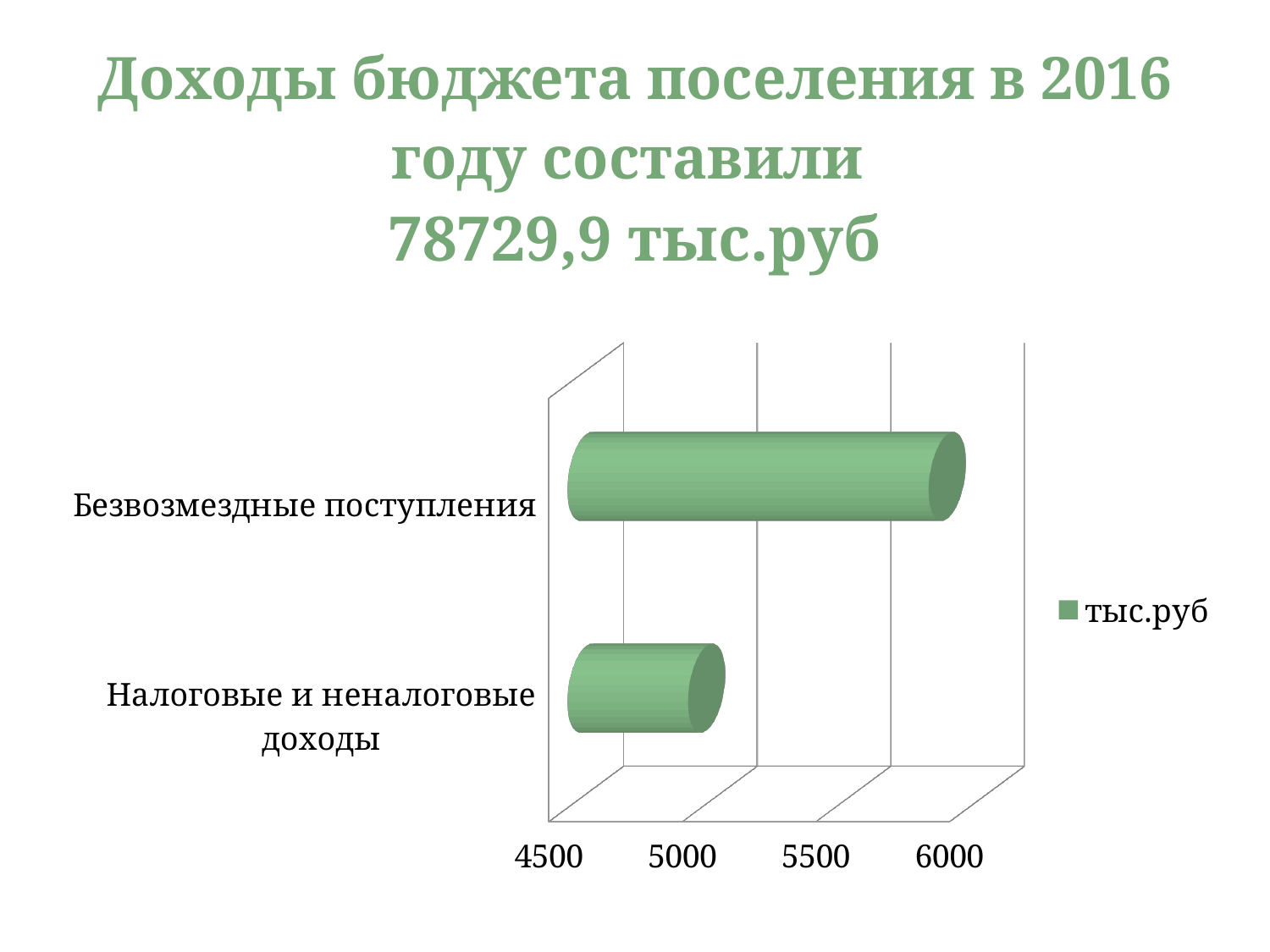
How many series does the legend list? 1 What kind of chart is shown on the slide? bar chart Which category has the lowest value in the chart? Налоговые и неналоговые доходы How many categories are plotted in the chart? 2 Which category has the highest value in the chart? Безвозмездные поступления Is the value for Безвозмездные поступления greater or less than 5500? greater Which is larger: the value for Безвозмездные поступления or the value for Налоговые и неналоговые доходы? Безвозмездные поступления Is the value for Налоговые и неналоговые доходы greater or less than 4500? greater What is the legend entry shown in the chart? тыс.руб According to the slide title, what were the total budget revenues of the settlement in 2016? 78729,9 тыс.руб Is the value for Налоговые и неналоговые доходы greater or less than 5500? less